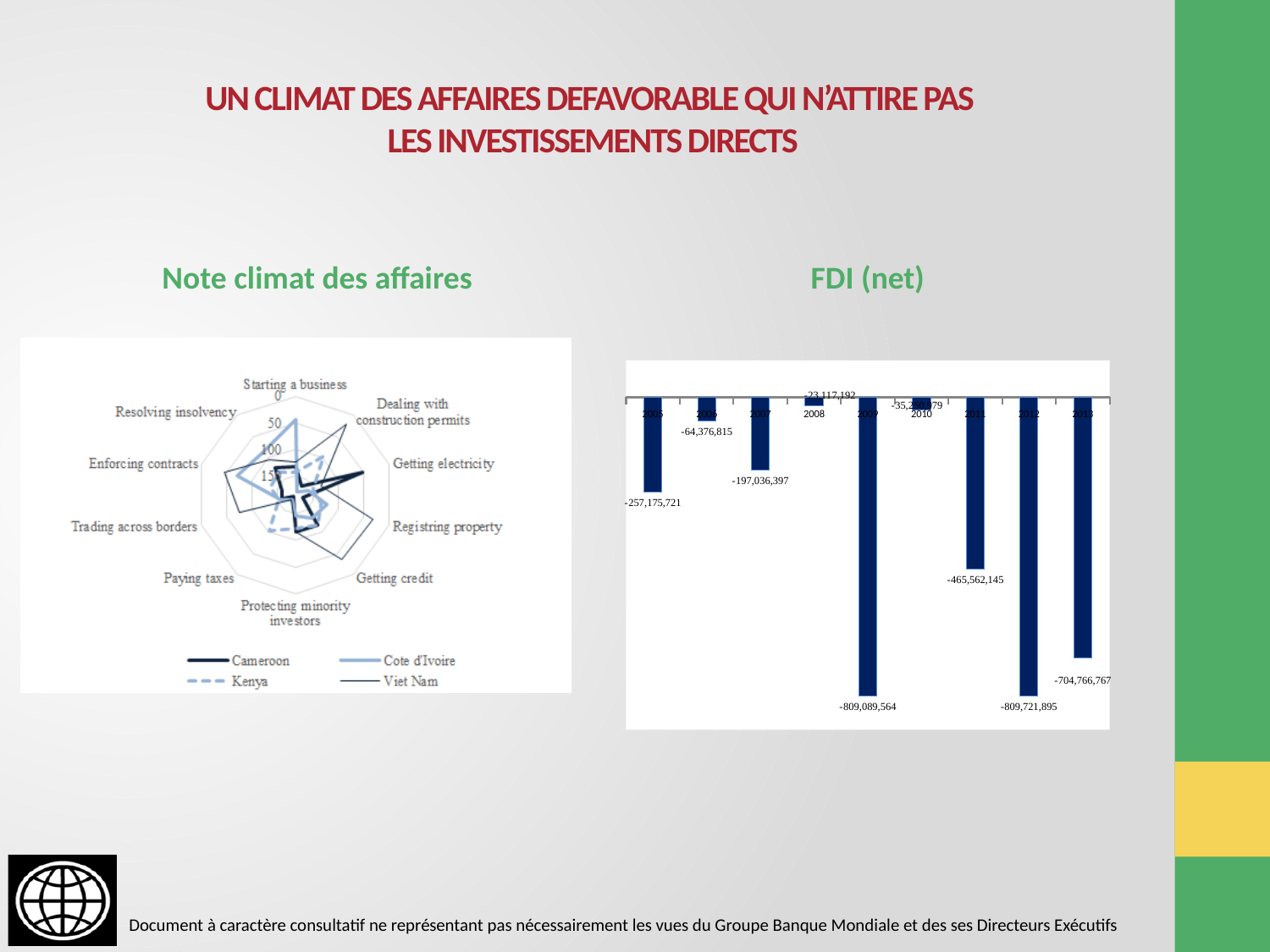
What kind of chart is the FDI (net) chart? Bar chart In the FDI (net) chart, what is the value for 2013? -704,766,767 In the FDI (net) chart, what is the value for 2006? -64,376,815 In the FDI (net) chart, which year has the value closest to zero? 2008 In the FDI (net) chart, what is the value for 2012? -809,721,895 In the FDI (net) chart, what is the value for 2011? -465,562,145 In the FDI (net) chart, what is the value for 2005? -257,175,721 In the FDI (net) chart, what is the difference between the values for 2013 and 2011? 239,204,622 How many countries does the legend of the Note climat des affaires chart list? 4 In the FDI (net) chart, what is the value for 2009? -809,089,564 In the FDI (net) chart, which year has the larger negative value, 2005 or 2007? 2005 How many years are shown in the FDI (net) chart? 9